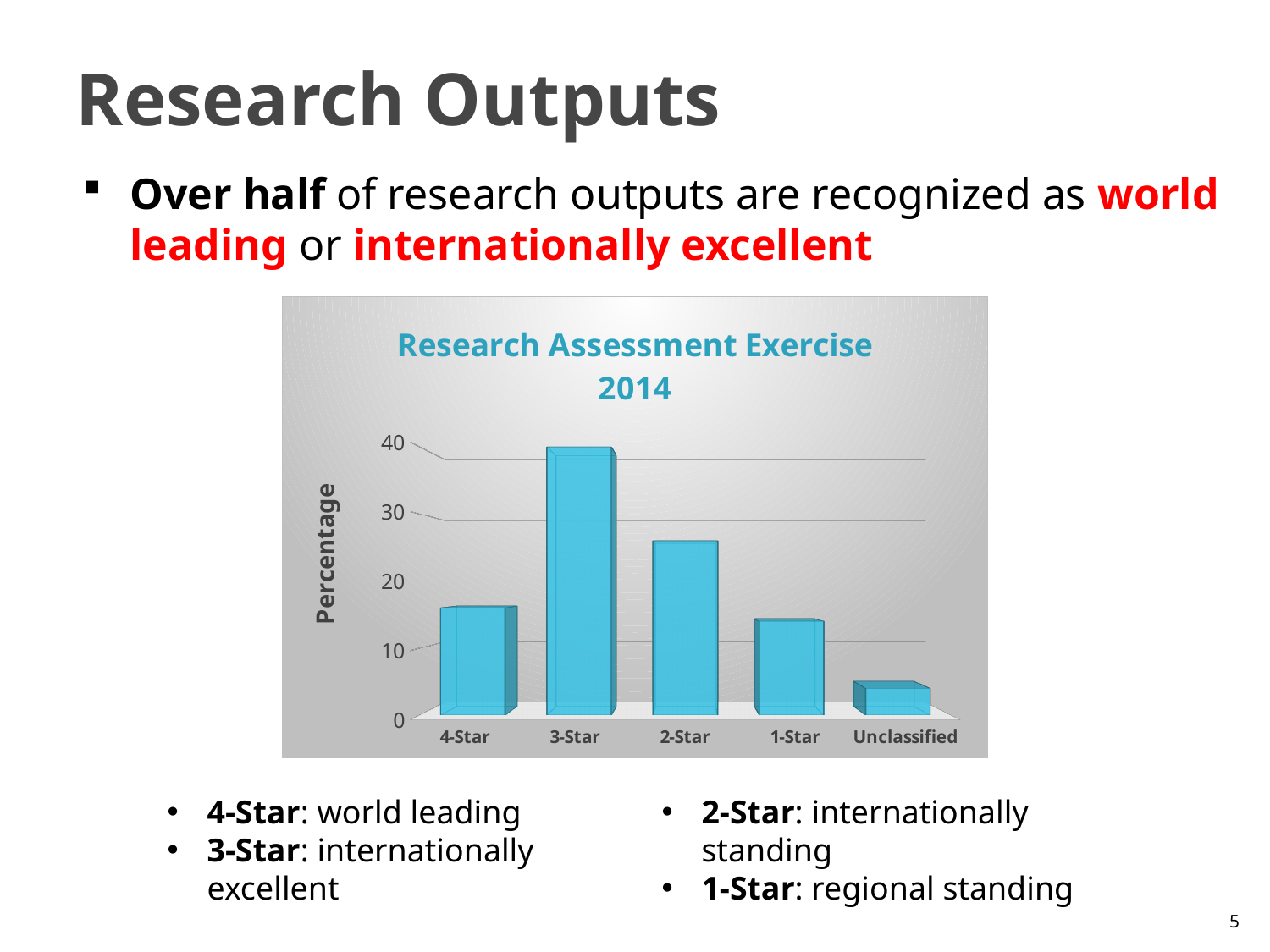
Which category has the lowest percentage? Unclassified Is the value for 2-Star greater or less than 20? greater Is the value for 3-Star greater or less than 30? greater Which category has the highest percentage? 3-Star Which is larger, the value for 2-Star or the value for 4-Star? 2-Star How many categories are shown on the x axis of the chart? 5 Is the value for 4-Star greater or less than 20? less What is the label on the vertical axis of the chart? Percentage What is the title of the chart? Research Assessment Exercise 2014 Moving from 3-Star to Unclassified along the x axis, do the values rise or fall? fall What type of chart is shown on the slide? bar chart